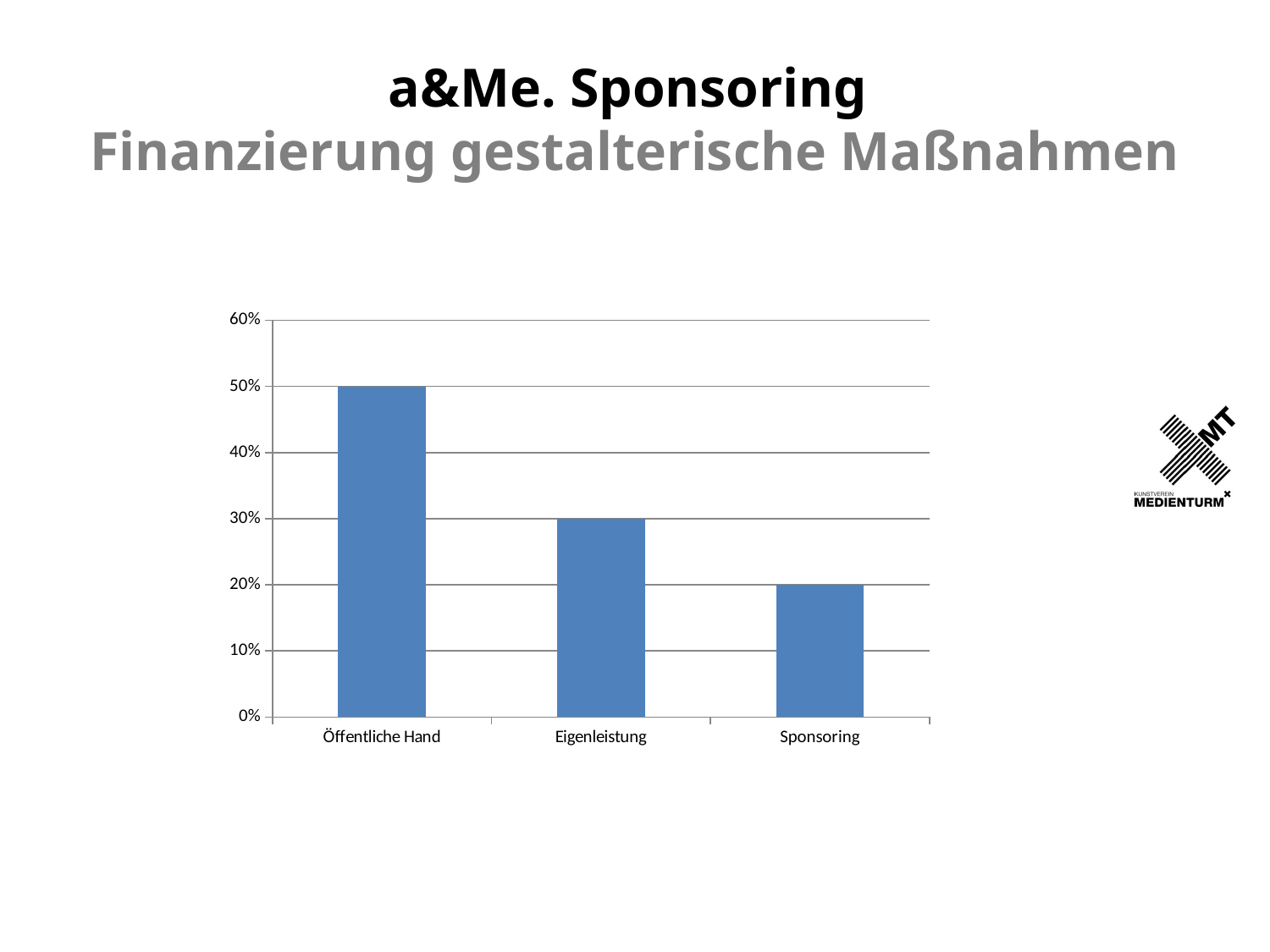
Is the value for Öffentliche Hand greater or less than 40%? greater Which category has the highest value? Öffentliche Hand Which is larger, the value for Eigenleistung or the value for Sponsoring? Eigenleistung How many categories are shown on the x axis? 3 Which category has the lowest value? Sponsoring What is the value for Sponsoring? 20% What is the value for Öffentliche Hand? 50% What is the difference between the values for Eigenleistung and Sponsoring? 10% What is the difference between the values for Öffentliche Hand and Sponsoring? 30% What is the value for Eigenleistung? 30% Do the values rise or fall from left to right along the x axis? fall What kind of chart is shown on the slide? bar chart